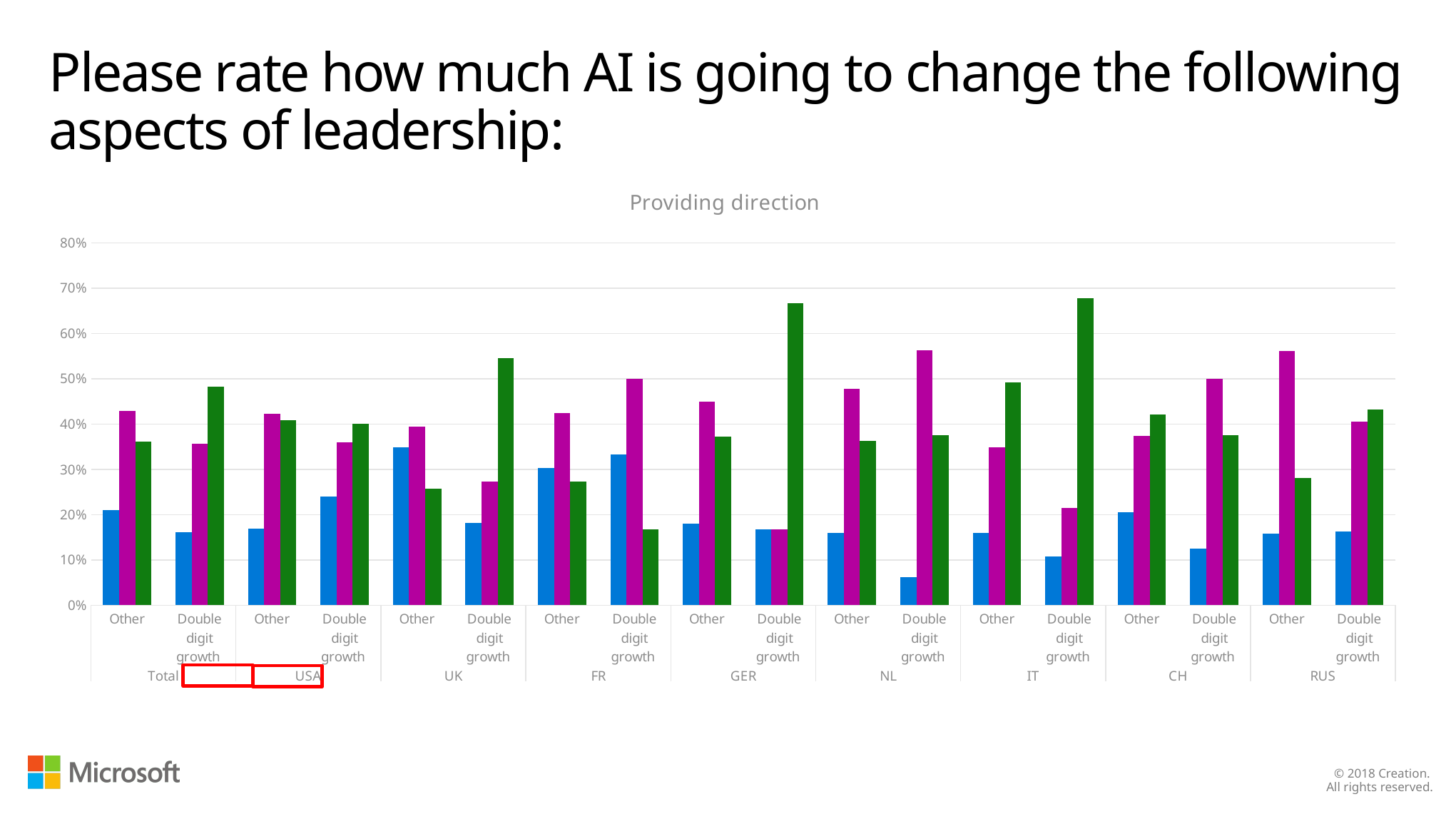
Is the green bar for 'Double digit growth' under FR greater or less than 20%? less Under Total 'Other', which is larger: the blue bar or the magenta bar? the magenta bar Is the green bar for 'Double digit growth' under IT greater or less than 60%? greater What is the title of the chart? Providing direction Is the magenta bar for 'Other' under RUS greater or less than 50%? greater How many bars are plotted for each category (e.g. for 'Other' under Total)? 3 How many country/region groups are shown along the x axis of the chart? 9 Under UK, is the green bar larger for 'Other' or for 'Double digit growth'? Double digit growth What kind of chart is shown on the slide? bar chart